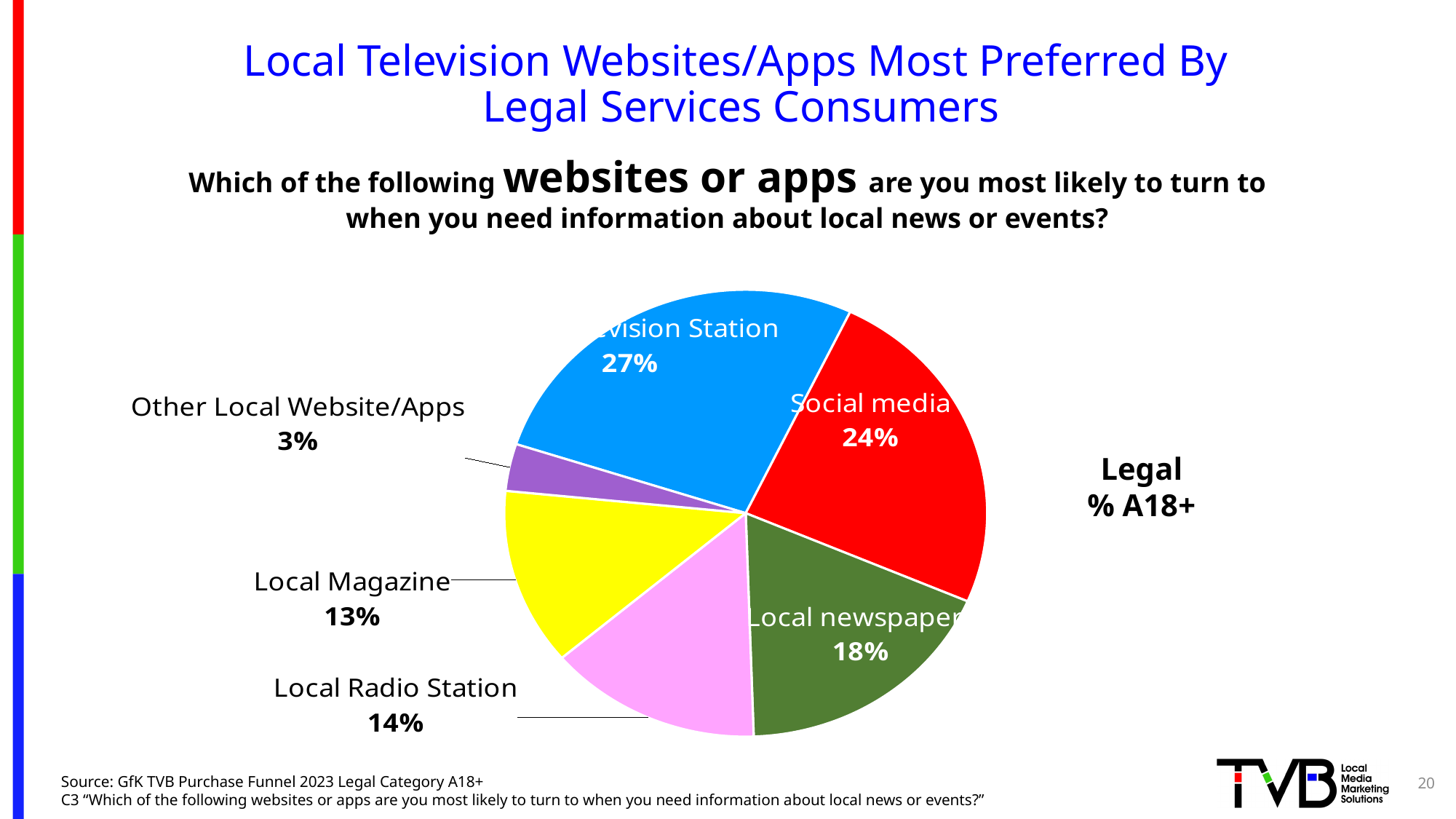
What is the difference between the Social media and Local newspaper shares? 6% What colour is the Social media slice? red What kind of chart is shown on the slide? pie chart Which category has the largest share of the pie? Local Television Station What is the value for Local Magazine? 13% Which category has the smallest share of the pie? Other Local Website/Apps What is the value for Local newspaper? 18% How many slices does the pie chart have? 6 What is the value for Other Local Website/Apps? 3% Which is larger, Local Radio Station or Local Magazine? Local Radio Station What is the value for Local Radio Station? 14% What percentage of legal services consumers chose Social media? 24%